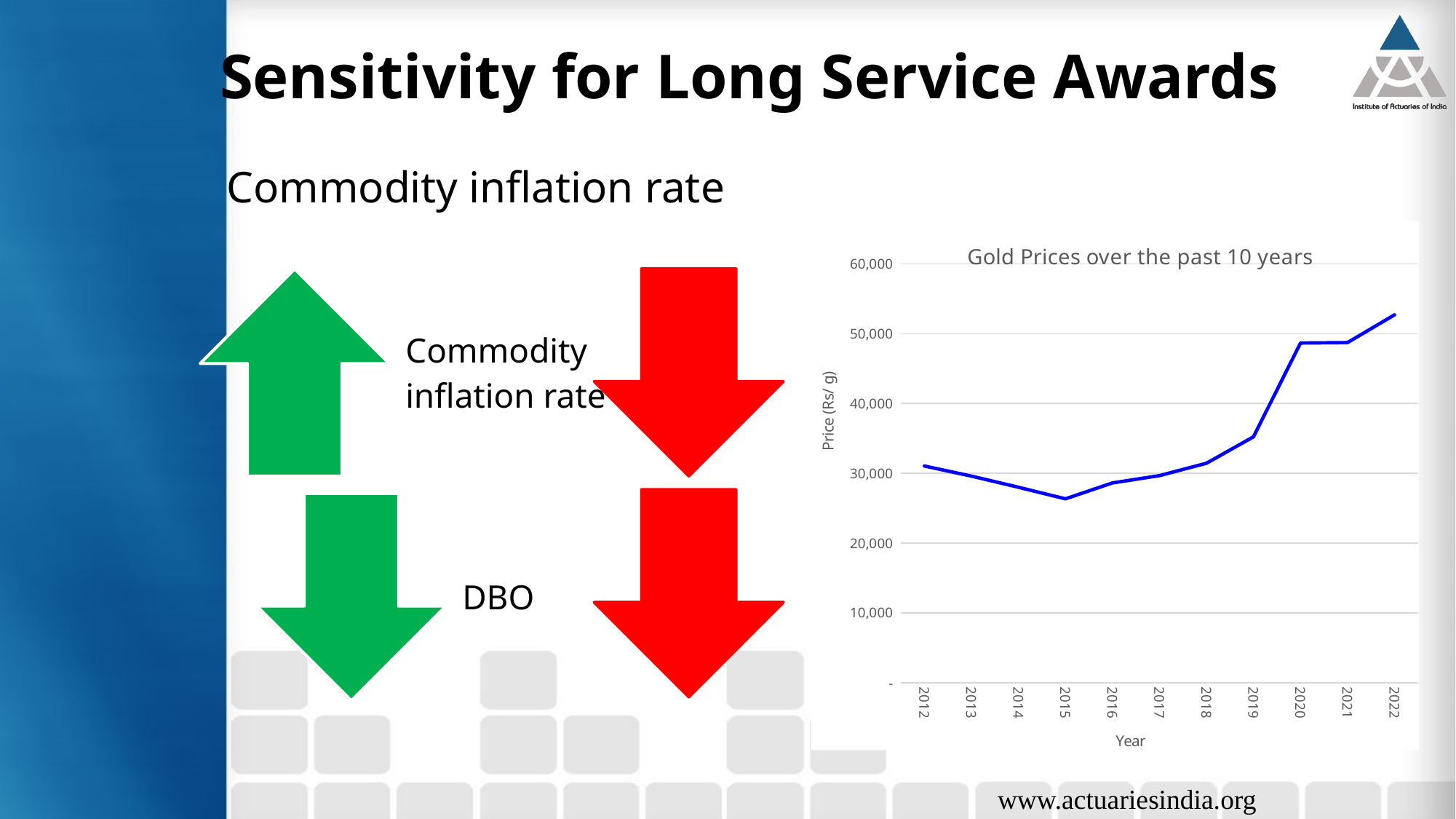
What is the title of the chart on the slide? Gold Prices over the past 10 years What kind of chart is shown on the slide? line chart Which year has a higher gold price, 2012 or 2015? 2012 How many years are plotted on the x axis of the chart? 11 In which year is the gold price highest on the chart? 2022 Is the gold price for 2022 greater or less than 50,000? greater Is the gold price for 2015 greater or less than 30,000? less What is the label of the vertical axis of the chart? Price (Rs/ g) Do gold prices rise or fall between 2015 and 2022 on the chart? rise Is the gold price for 2019 greater or less than 40,000? less In which year is the gold price lowest on the chart? 2015